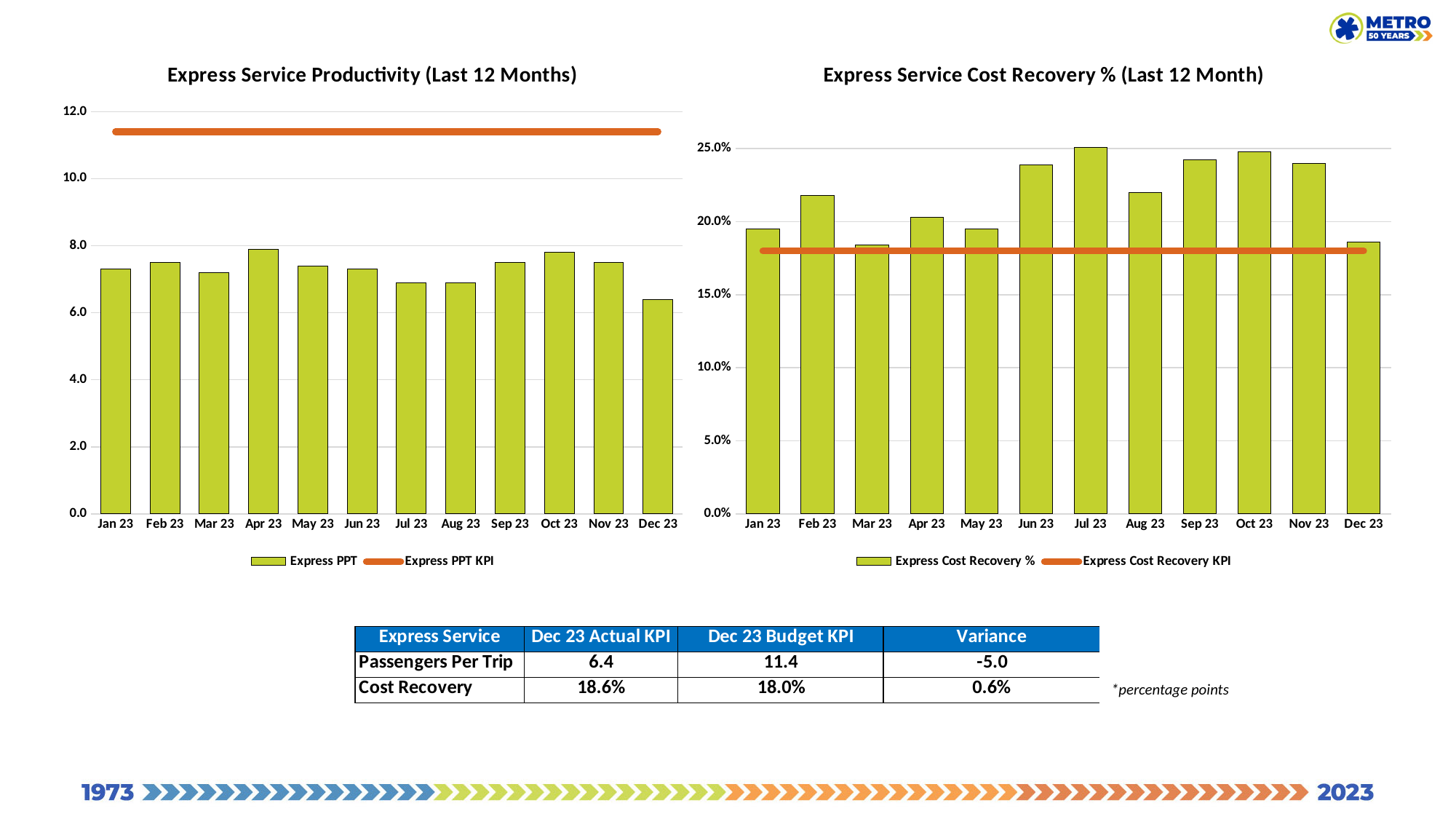
On the Express Service Cost Recovery % chart, what value does the Express Cost Recovery KPI line sit at? 18.0% On the Express Service Productivity chart, what is the Express PPT value for Dec 23? 6.4 On the Express Service Productivity chart, what value does the Express PPT KPI line sit at? 11.4 How many months are shown on the x axis of the Express Service Productivity chart? 12 What kind of chart is the Express Service Productivity (Last 12 Months) chart? Combination bar and line chart On the Express Service Cost Recovery % chart, is the value for Jun 23 greater or less than 20.0%? greater On the Express Service Cost Recovery % chart, which month has the highest cost recovery bar? Jul 23 On the Express Service Cost Recovery % chart, which month has the larger bar, Feb 23 or Mar 23? Feb 23 How many series does the legend of the Express Service Cost Recovery % chart list? 2 On the Express Service Productivity chart, which month has the lowest Express PPT bar? Dec 23 On the Express Service Cost Recovery % chart, what is the cost recovery value for Dec 23? 18.6%